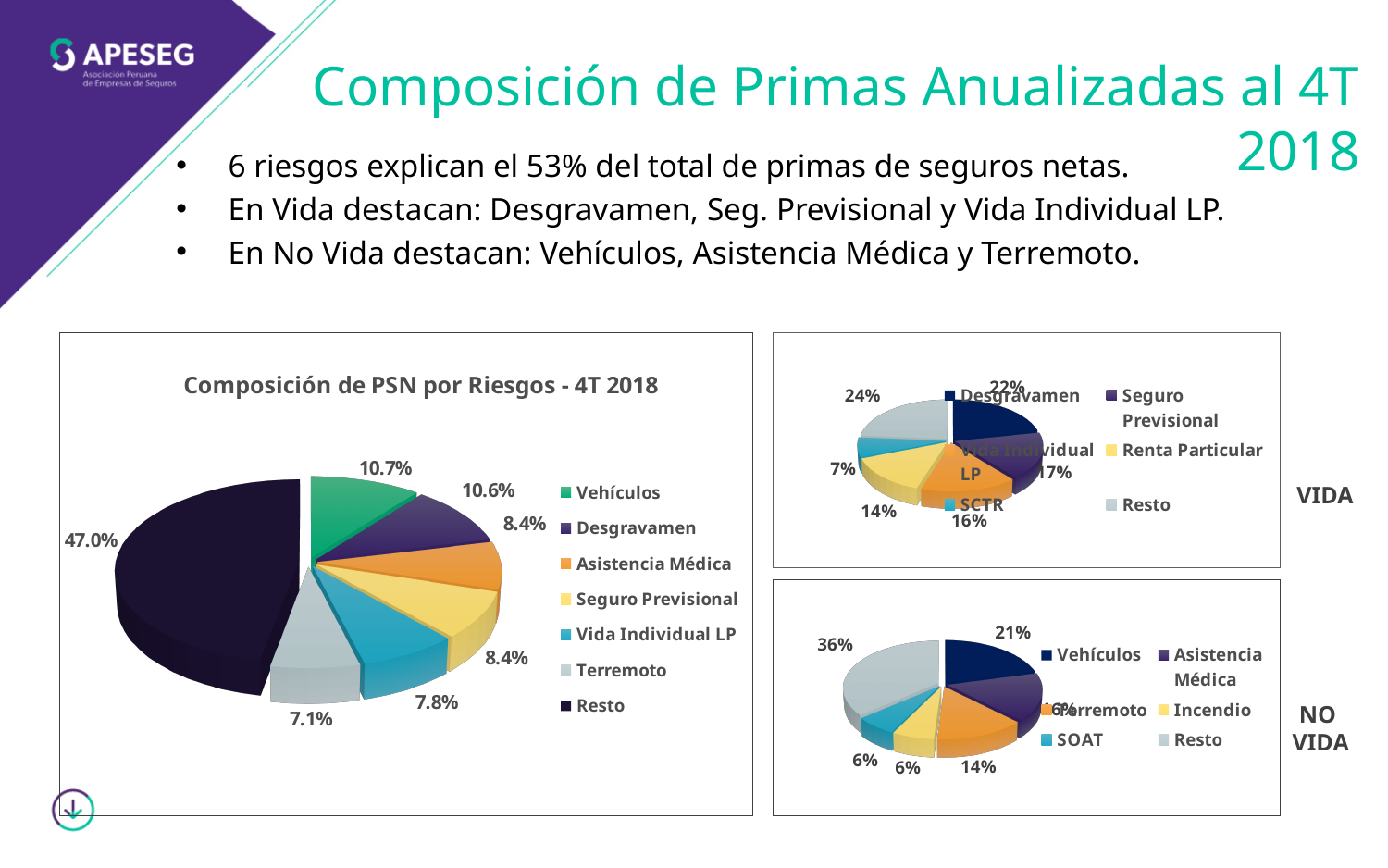
In the chart titled 'Composición de PSN por Riesgos - 4T 2018', which category has the smallest share? Terremoto In the VIDA chart on the right, what share does Resto have? 24% What kind of chart is 'Composición de PSN por Riesgos - 4T 2018'? Pie chart In the VIDA chart on the right, what share does Desgravamen have? 22% In the chart titled 'Composición de PSN por Riesgos - 4T 2018', which category has the largest share? Resto In the chart titled 'Composición de PSN por Riesgos - 4T 2018', what is the value for Vehículos? 10.7% In the NO VIDA chart on the right, which is larger, Vehículos or Resto? Resto In the NO VIDA chart on the right, what share does Resto have? 36% In the chart titled 'Composición de PSN por Riesgos - 4T 2018', what is the difference between Vehículos and Vida Individual LP? 2.9% In the chart titled 'Composición de PSN por Riesgos - 4T 2018', how many categories does the legend list? 7 In the chart titled 'Composición de PSN por Riesgos - 4T 2018', what share does Resto have? 47.0% In the chart titled 'Composición de PSN por Riesgos - 4T 2018', what is the value for Terremoto? 7.1%